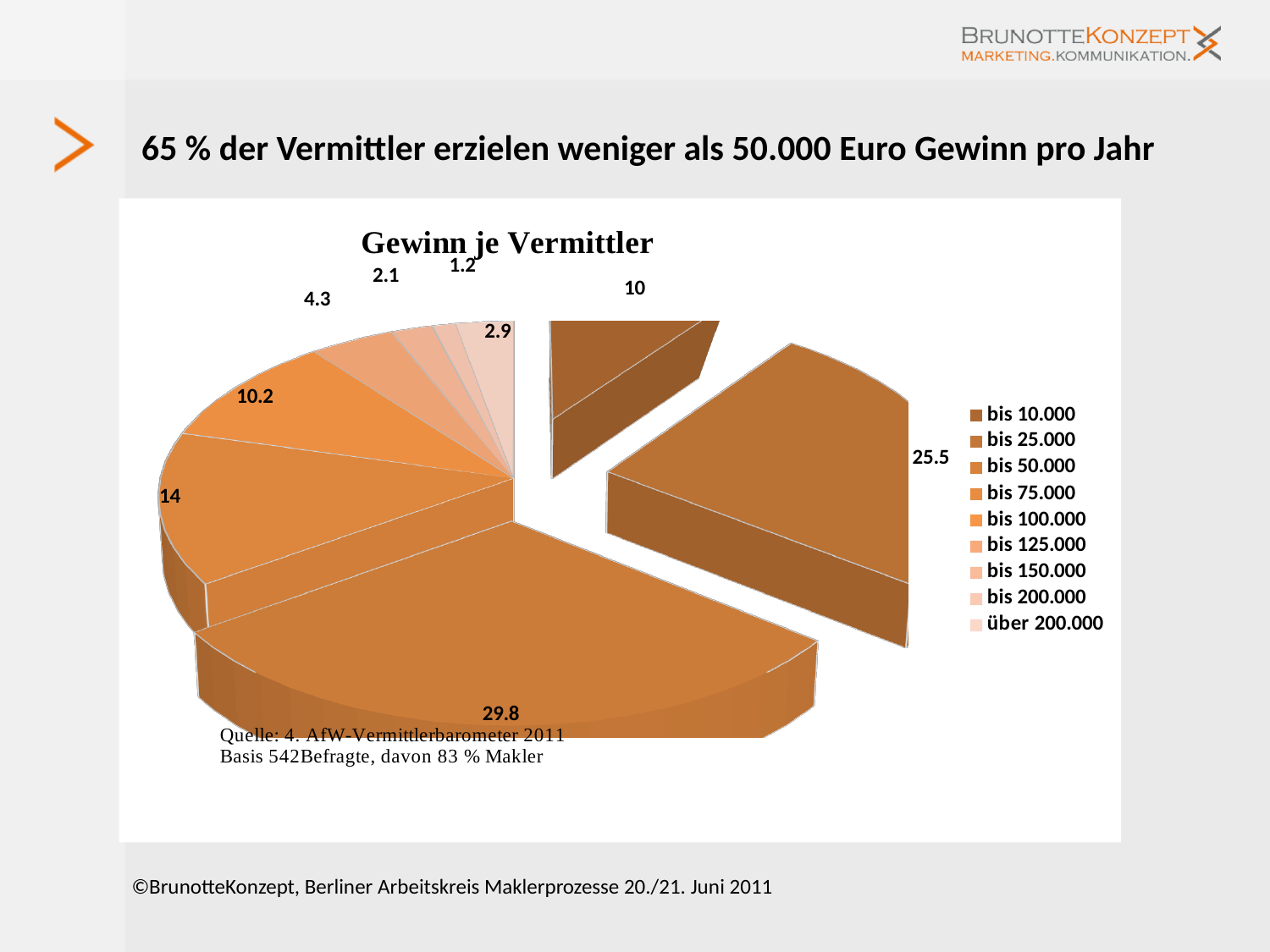
Which category has the largest slice of the pie? bis 50.000 What is the difference between the 'bis 50.000' and 'bis 25.000' values? 4.3 What is the title of the chart? Gewinn je Vermittler What is the value for the 'bis 10.000' slice? 10 What kind of chart is shown on the slide? pie chart What is the value for the 'über 200.000' slice? 2.9 Which is larger, the 'bis 75.000' slice or the 'bis 100.000' slice? bis 75.000 What is the value for the 'bis 50.000' slice? 29.8 How many categories does the legend of the pie chart list? 9 Which category has the smallest slice of the pie? bis 200.000 What is the combined value of the 'bis 10.000', 'bis 25.000' and 'bis 50.000' slices? 65.3 What is the value for the 'bis 25.000' slice? 25.5